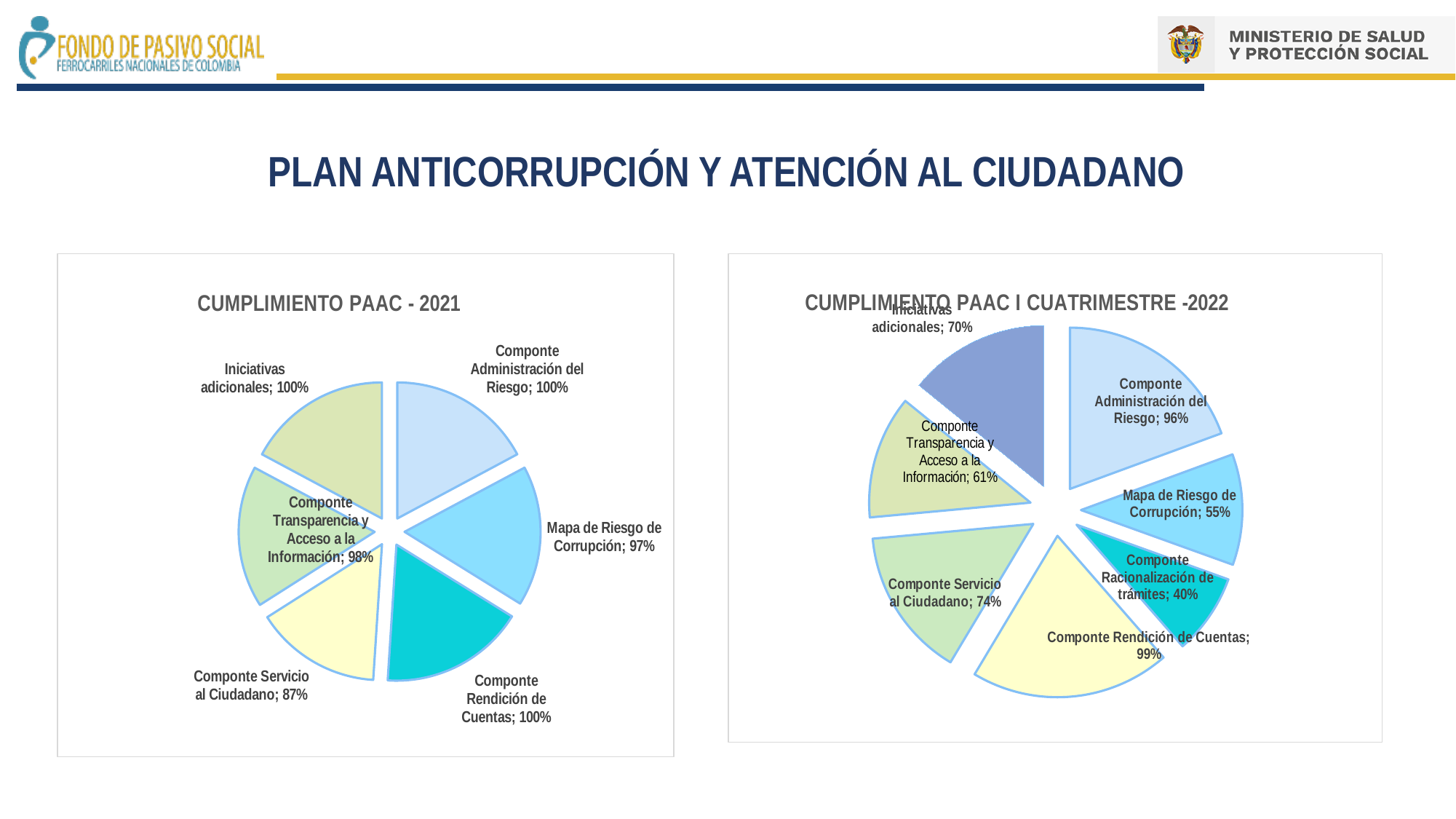
In the CUMPLIMIENTO PAAC - 2021 chart, what is the value for Componte Servicio al Ciudadano? 87% In the CUMPLIMIENTO PAAC I CUATRIMESTRE -2022 chart, what is the value for Componte Racionalización de trámites? 40% In the CUMPLIMIENTO PAAC I CUATRIMESTRE -2022 chart, what is the value for Iniciativas adicionales? 70% In the CUMPLIMIENTO PAAC - 2021 chart, what is the value for Mapa de Riesgo de Corrupción? 97% How many categories are shown in the CUMPLIMIENTO PAAC I CUATRIMESTRE -2022 chart? 7 In the CUMPLIMIENTO PAAC I CUATRIMESTRE -2022 chart, which category has the lowest value? Componte Racionalización de trámites In the CUMPLIMIENTO PAAC I CUATRIMESTRE -2022 chart, which category has the highest value? Componte Rendición de Cuentas In the CUMPLIMIENTO PAAC - 2021 chart, which category has the lowest value? Componte Servicio al Ciudadano In the CUMPLIMIENTO PAAC I CUATRIMESTRE -2022 chart, which is larger, Componte Servicio al Ciudadano or Componte Transparencia y Acceso a la Información? Componte Servicio al Ciudadano How many categories are shown in the CUMPLIMIENTO PAAC - 2021 chart? 6 What type of chart is the CUMPLIMIENTO PAAC - 2021 chart? Pie chart In the CUMPLIMIENTO PAAC I CUATRIMESTRE -2022 chart, what is the difference between Componte Administración del Riesgo and Mapa de Riesgo de Corrupción? 41%